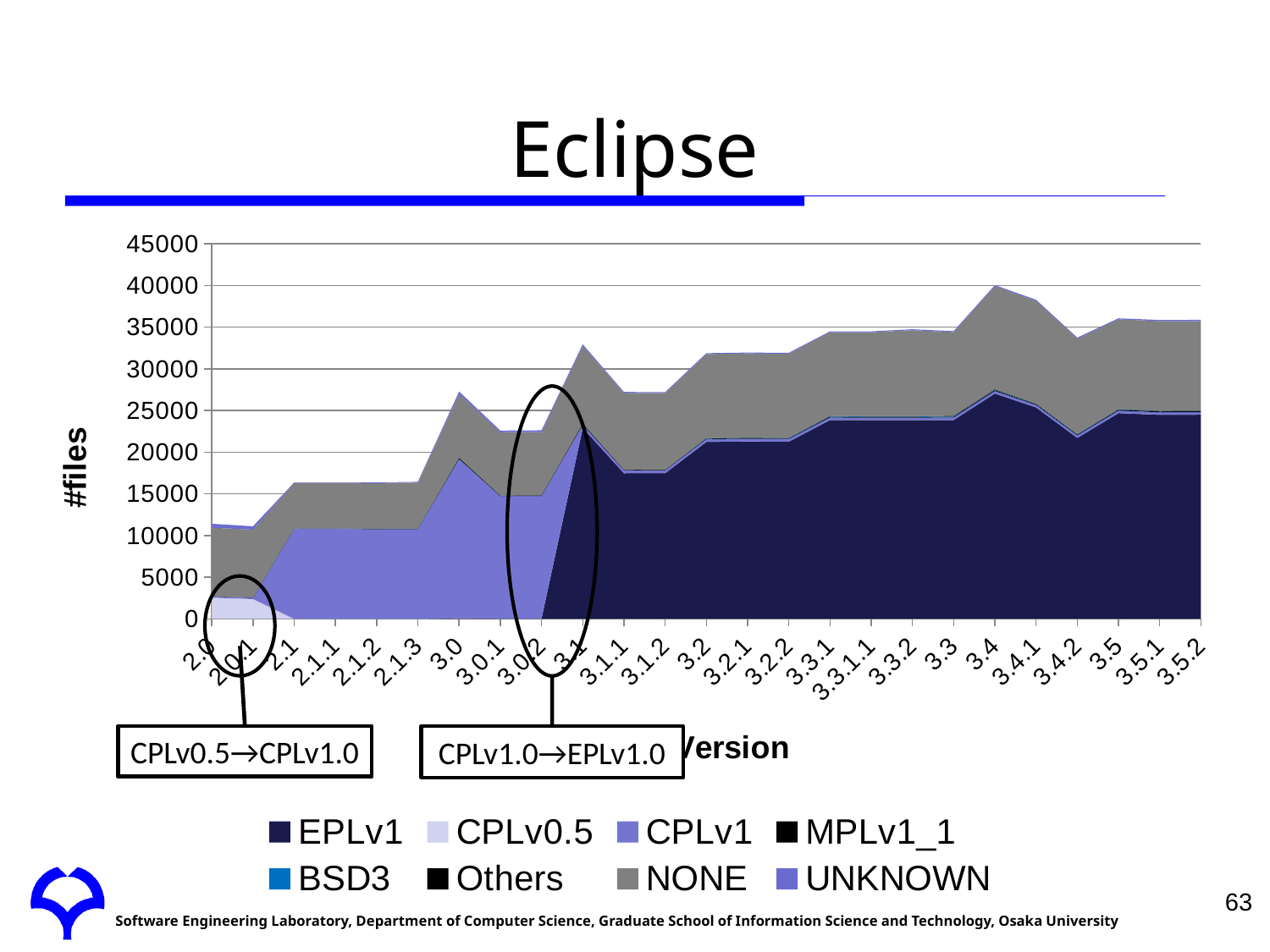
Which version has a larger total number of files, 3.4 or 3.4.2? 3.4 Is the number of EPLv1 files at version 3.5.2 greater or less than 20000? greater What is the title of the chart? Eclipse Which version has a larger total number of files, 3.0 or 3.0.1? 3.0 Is the total number of files at version 3.5.2 greater or less than 30000? greater What is the label of the vertical axis? #files At which version does the total number of files reach its highest point? 3.4 Is the total number of files at version 3.1 greater or less than 30000? greater What kind of chart is shown on the slide? Stacked area chart Does the total number of files generally rise or fall from version 2.0 to version 3.5.2? rise How many series does the legend list? 8